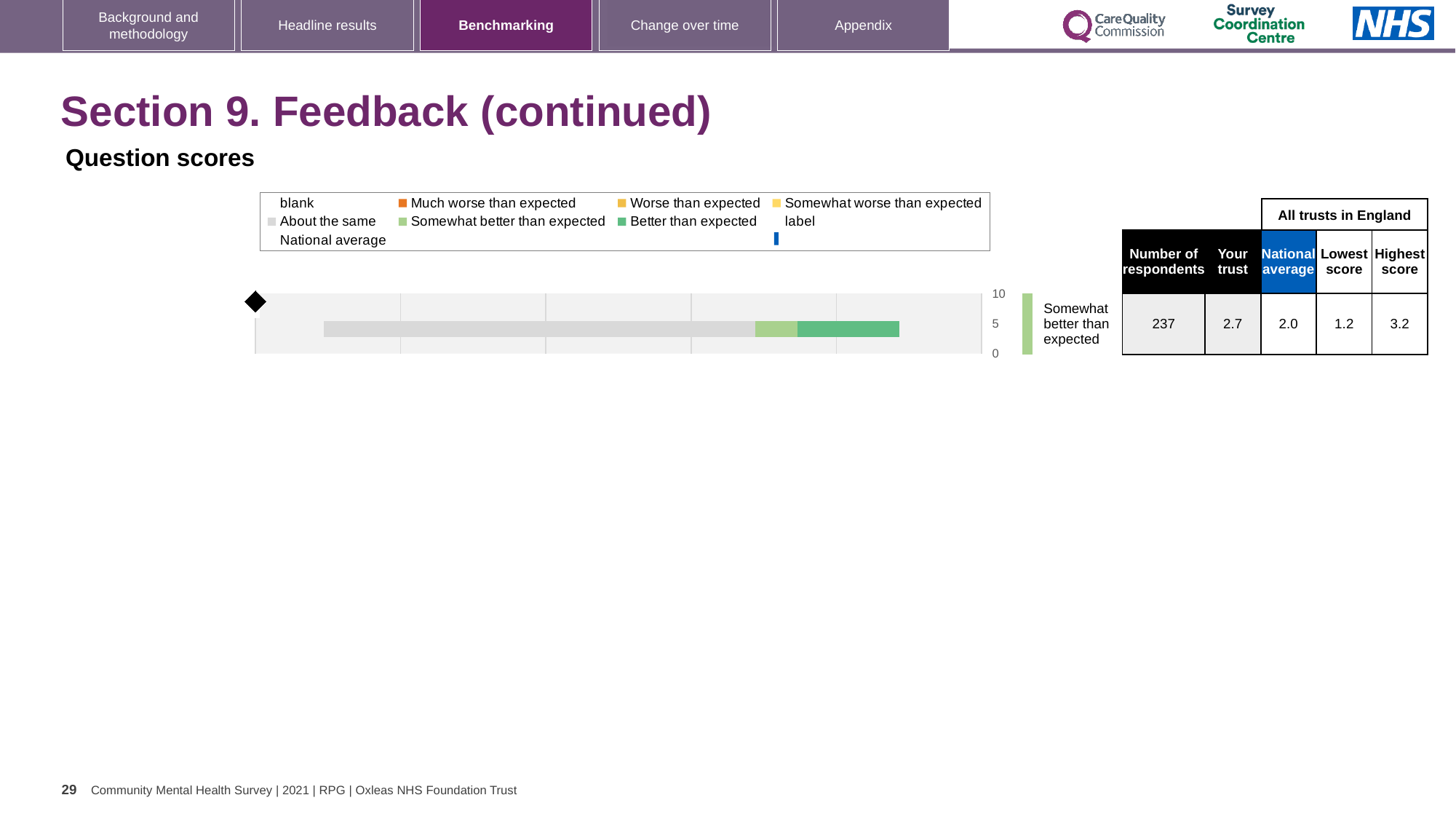
In the table beside the chart, what is the number of respondents? 237 In the table beside the chart, what is the lowest score among all trusts in England? 1.2 What benchmark label is shown next to the bar in the chart? Somewhat better than expected What kind of chart is shown on the slide? bar chart In the table beside the chart, what is the score for 'Your trust'? 2.7 How many entries does the chart legend list? 9 What colour does the legend use for 'About the same'? grey In the table beside the chart, what is the highest score among all trusts in England? 3.2 In the table beside the chart, what is the national average score? 2.0 In the table beside the chart, which is larger: the 'Your trust' score or the national average? Your trust What colour does the legend use for 'Better than expected'? green How many bars are plotted in the chart? 1